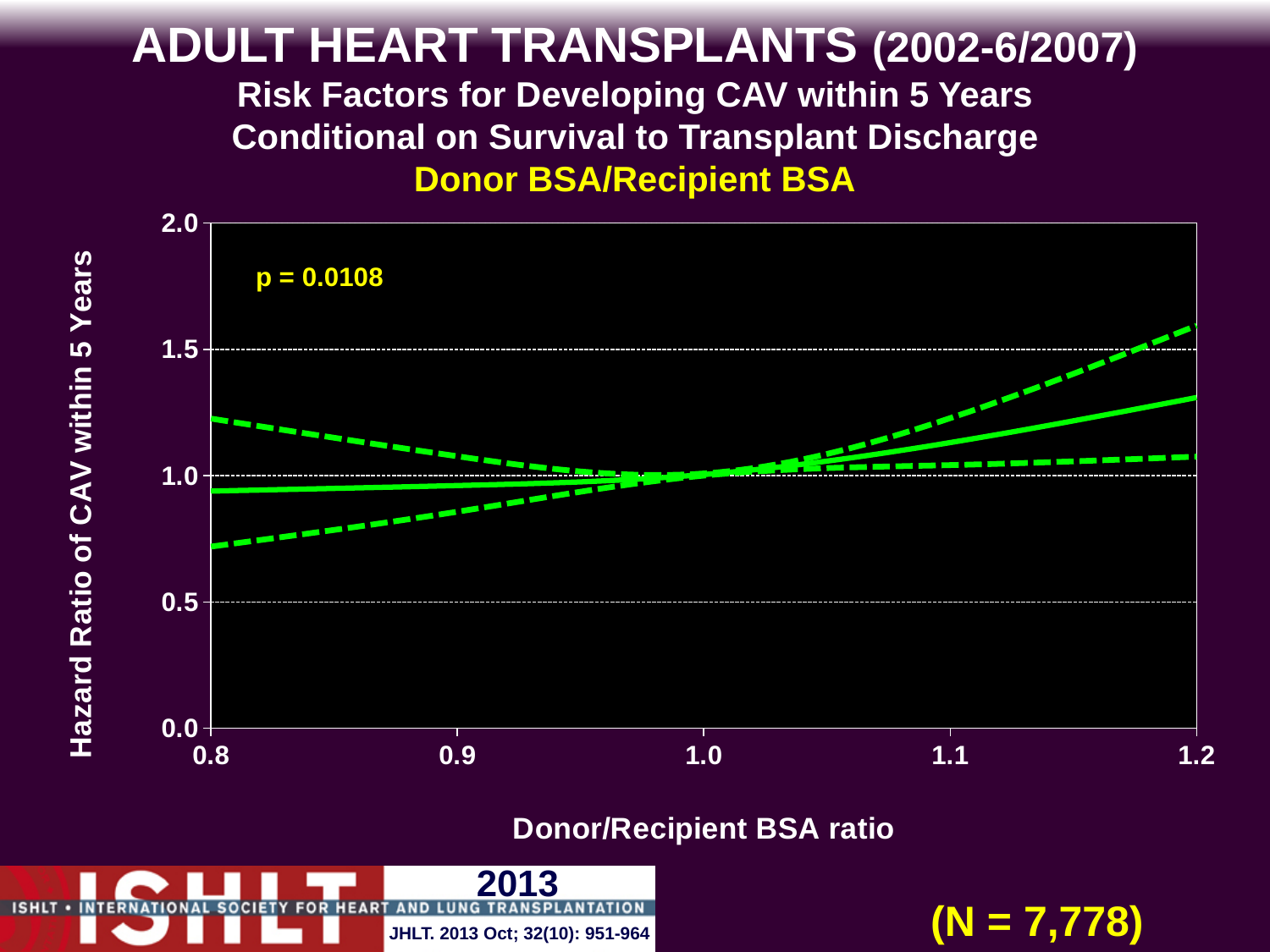
Is the lower dashed line at a Donor/Recipient BSA ratio of 0.8 greater or less than 0.5? greater What is the lowest value shown on the x axis? 0.8 What p-value is printed on the chart? p = 0.0108 Is the hazard ratio on the solid line at a Donor/Recipient BSA ratio of 0.8 greater or less than 1.0? less Is the hazard ratio on the solid line at a Donor/Recipient BSA ratio of 1.2 greater or less than 1.0? greater What is the highest value shown on the y axis? 2.0 Is the solid line's hazard ratio higher at a BSA ratio of 1.2 or at 0.8? 1.2 Does the solid line (hazard ratio) rise or fall as the Donor/Recipient BSA ratio increases from 0.8 to 1.2? rise What kind of chart is shown on the slide? line chart How many lines are plotted on the chart? 3 What is the label of the x axis? Donor/Recipient BSA ratio